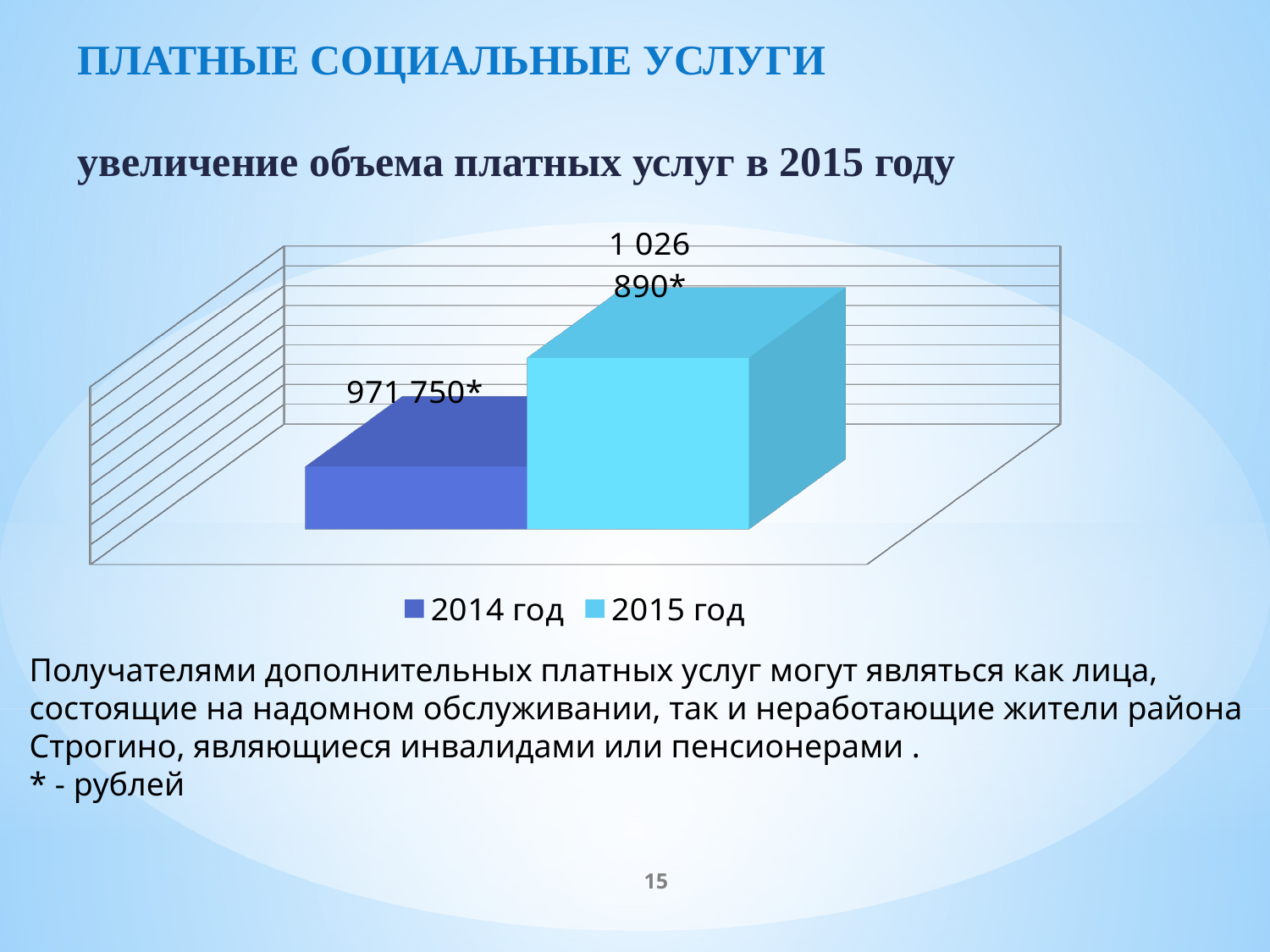
How many series does the legend list? 2 What is the value shown for 2015 год? 1 026 890* Which series has the highest value on the chart? 2015 год Which year has the higher value, 2014 год or 2015 год? 2015 год Do the values rise or fall from 2014 год to 2015 год? rise What is the value shown for 2014 год? 971 750* What colour is the bar for 2015 год? light blue Which series has the lowest value on the chart? 2014 год How many bars are plotted on the chart? 2 What kind of chart is shown on the slide? bar chart By how much does the 2015 год value exceed the 2014 год value? 55 140 What unit does the asterisk (*) on the data labels stand for, according to the slide? рублей